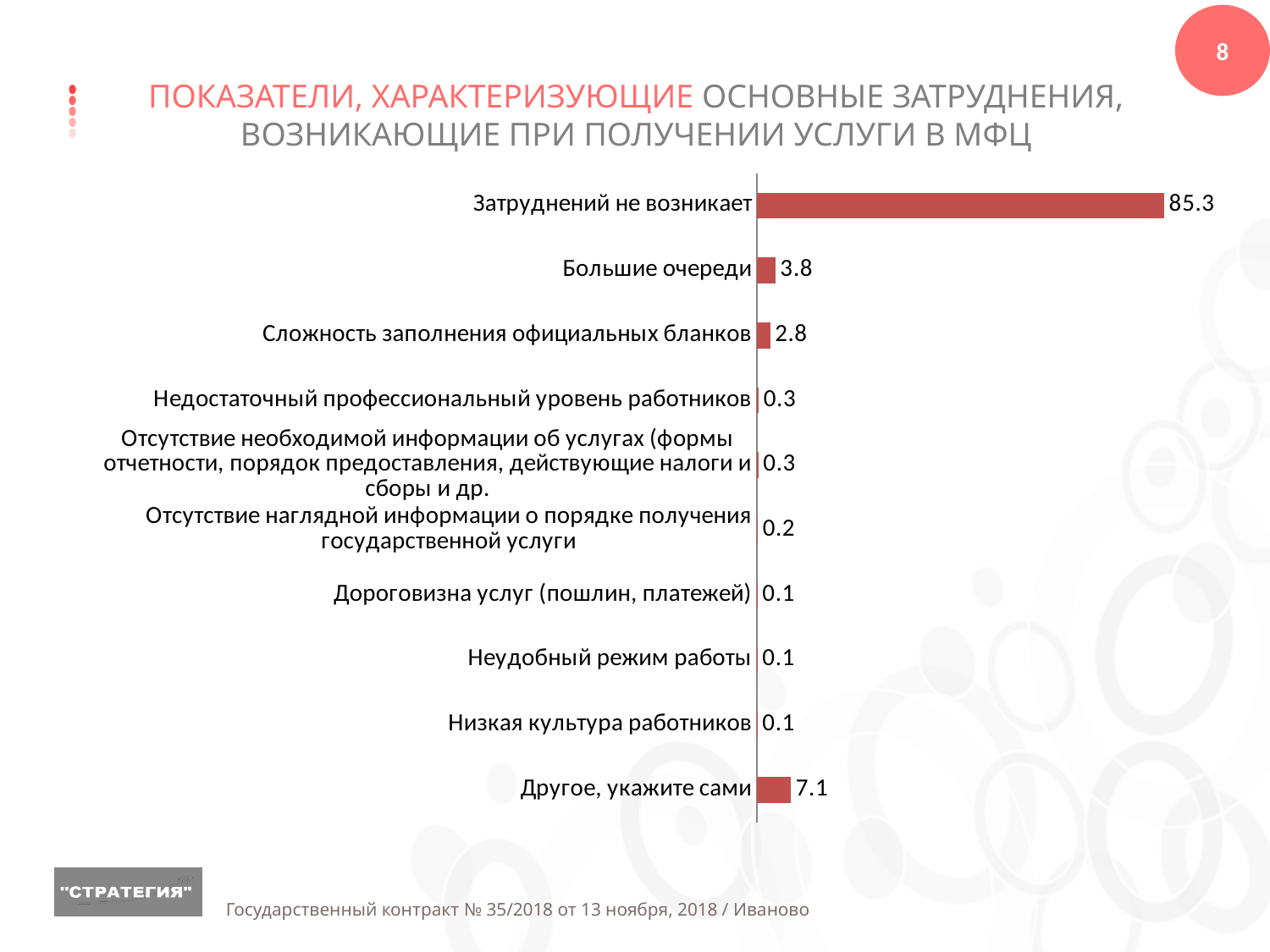
What is the value for "Большие очереди"? 3.8 What is the difference between the values for "Большие очереди" and "Сложность заполнения официальных бланков"? 1.0 What kind of chart is shown on the slide? bar chart Which is larger, the value for "Большие очереди" or the value for "Другое, укажите сами"? Другое, укажите сами What is the value for "Сложность заполнения официальных бланков"? 2.8 What is the value for "Затруднений не возникает"? 85.3 Which category has the highest value? Затруднений не возникает What is the value for "Другое, укажите сами"? 7.1 What is the value for "Недостаточный профессиональный уровень работников"? 0.3 What is the value for "Неудобный режим работы"? 0.1 How many categories are shown in the chart? 10 What is the difference between the values for "Затруднений не возникает" and "Другое, укажите сами"? 78.2